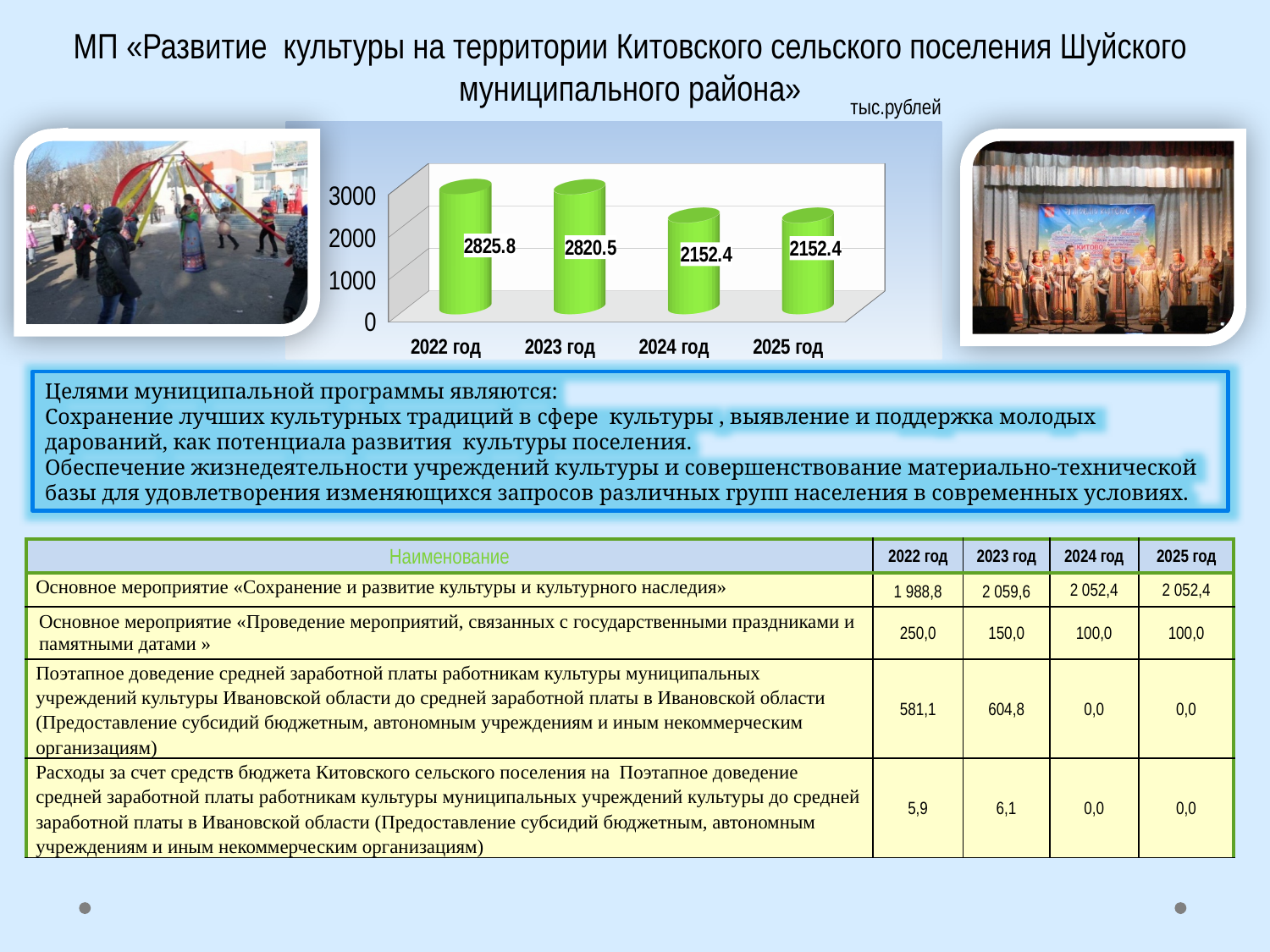
What is the value for 2024 год on the chart? 2152.4 What kind of chart is shown on the slide? bar chart Which year has the highest value on the chart? 2022 год What is the value for 2023 год on the chart? 2820.5 What is the difference between the values for 2023 год and 2024 год? 668.1 What unit is indicated for the chart values? тыс.рублей What is the value for 2022 год on the chart? 2825.8 Is the value for 2024 год greater or less than 3000? less How many years are shown on the chart? 4 What is the value for 2025 год on the chart? 2152.4 Which is larger, the value for 2023 год or the value for 2025 год? 2023 год What is the difference between the values for 2022 год and 2023 год? 5.3